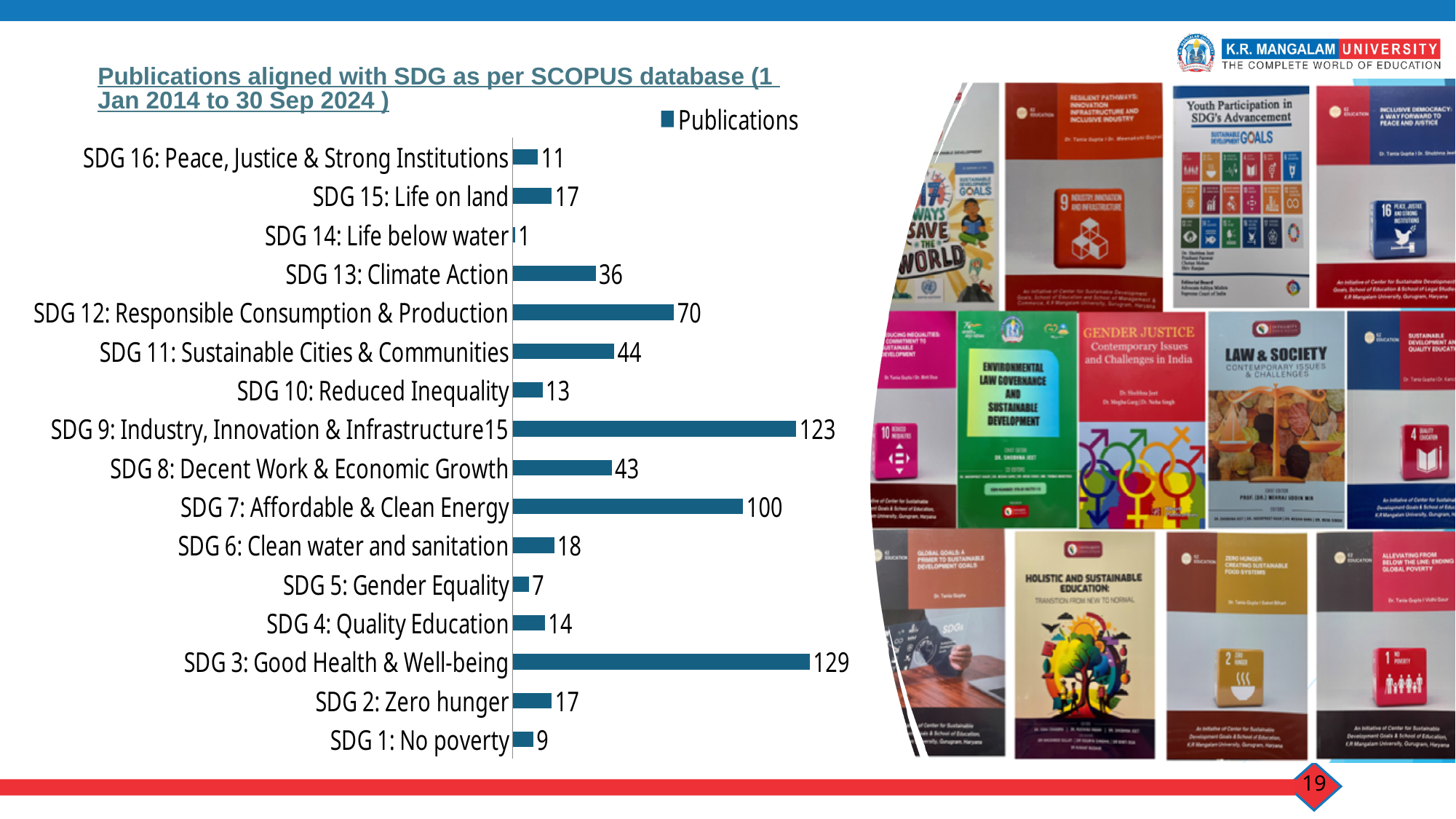
What is the value for SDG 13: Climate Action? 36 What type of chart is shown on the slide? Bar chart How many series does the legend list? 1 How many SDG categories are plotted in the chart? 16 What is the difference in publications between SDG 3: Good Health & Well-being and SDG 9: Industry, Innovation & Infrastructure? 6 What is the difference between the values for SDG 11: Sustainable Cities & Communities and SDG 8: Decent Work & Economic Growth? 1 Which SDG has the lowest number of publications? SDG 14: Life below water What is the value for SDG 12: Responsible Consumption & Production? 70 How many publications are shown for SDG 3: Good Health & Well-being? 129 How many publications are shown for SDG 7: Affordable & Clean Energy? 100 Which SDG has the highest number of publications? SDG 3: Good Health & Well-being Which has more publications, SDG 12: Responsible Consumption & Production or SDG 11: Sustainable Cities & Communities? SDG 12: Responsible Consumption & Production